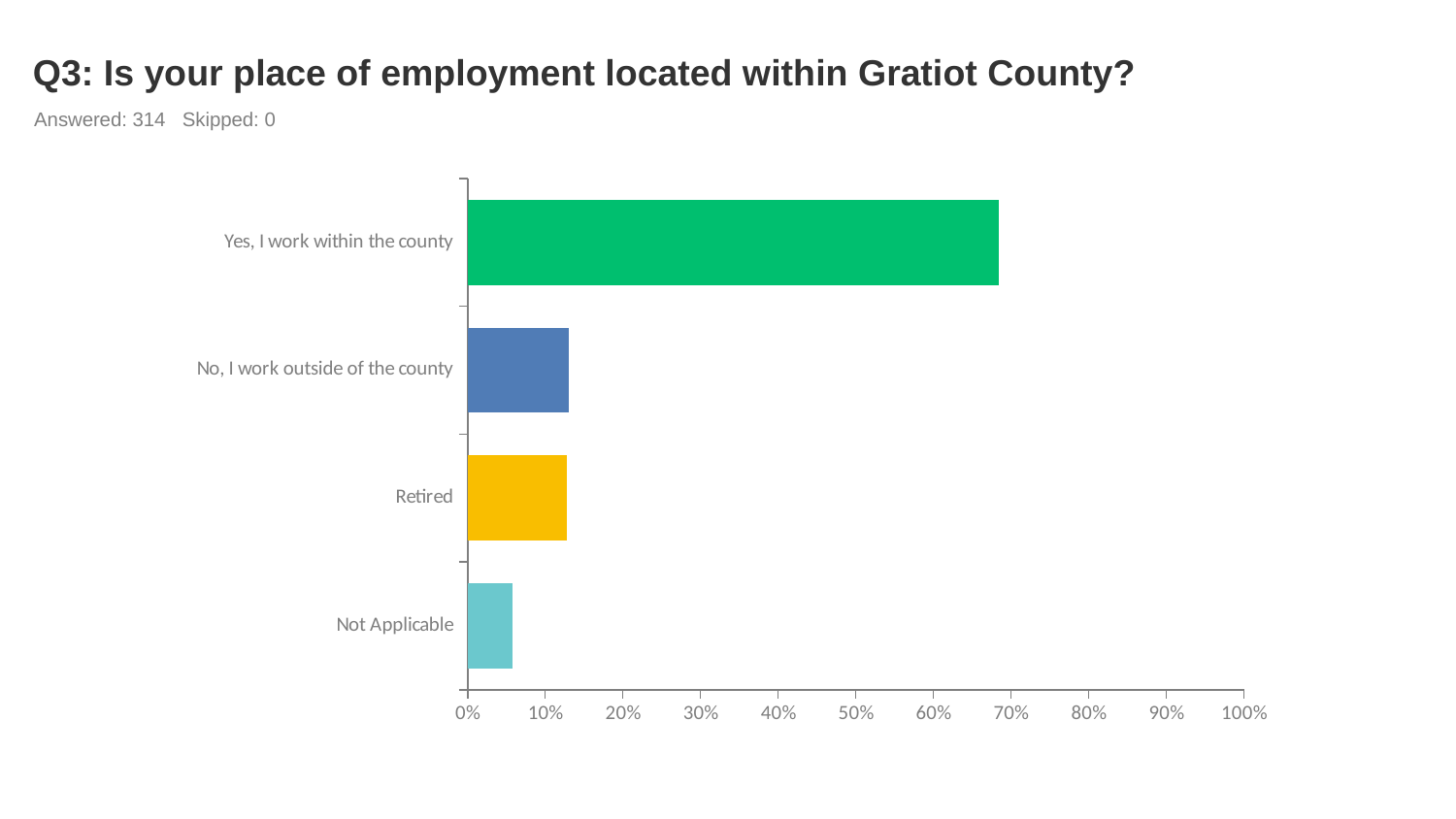
Is the value for "Retired" greater or less than 20%? less What kind of chart is shown on the slide? bar chart What is the title of the chart? Q3: Is your place of employment located within Gratiot County? Is the value for "No, I work outside of the county" greater or less than 10%? greater How many categories are plotted in the chart? 4 Which category has the lowest value? Not Applicable How many respondents answered the question according to the slide? 314 Which category has the highest value? Yes, I work within the county Which is larger, the value for "Yes, I work within the county" or the value for "Retired"? Yes, I work within the county Is the value for "Yes, I work within the county" greater or less than 60%? greater